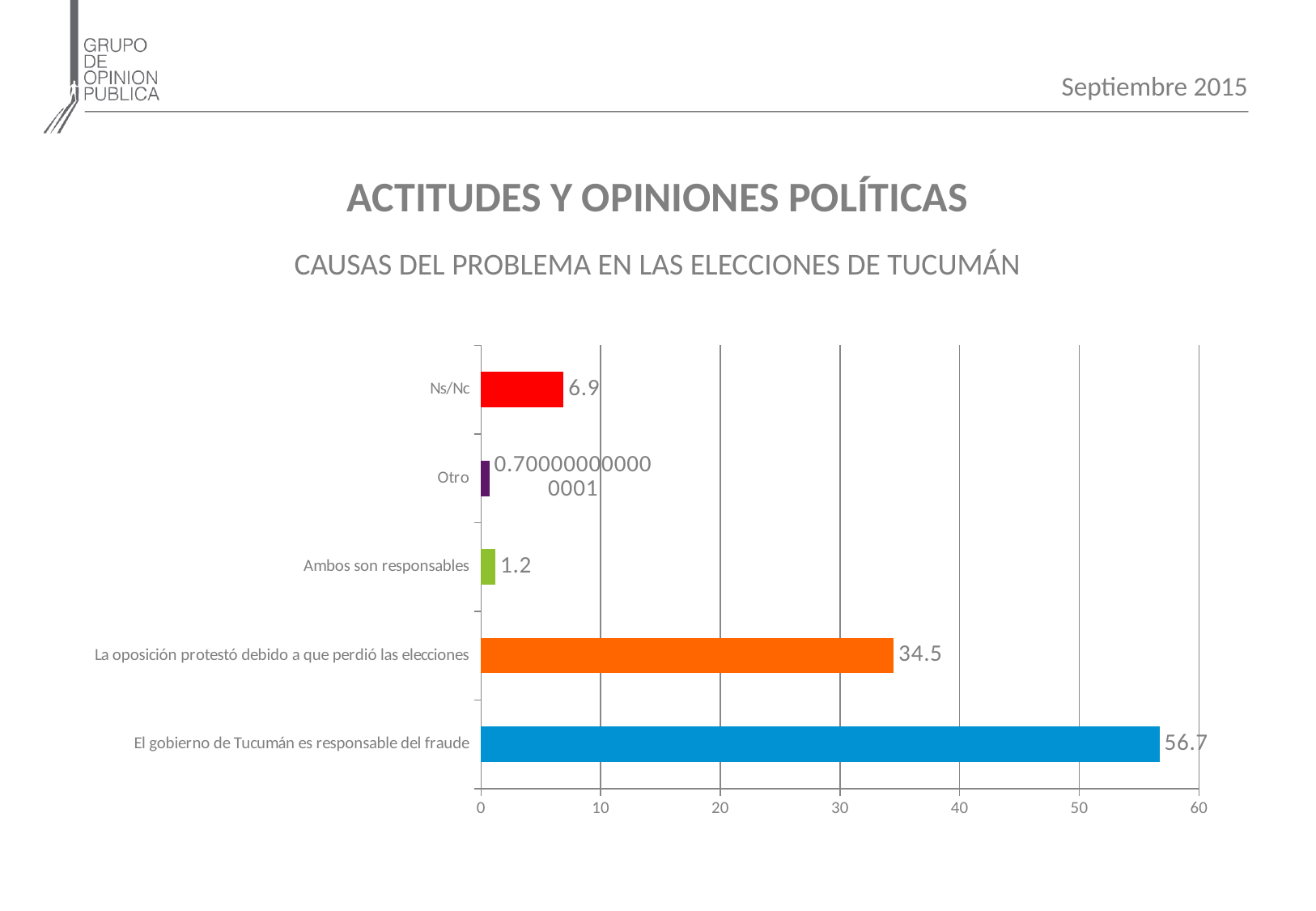
How many categories are shown in the chart? 5 Which category has the lowest value? Otro What is the value for "Ambos son responsables"? 1.2 What is the value for "Ns/Nc"? 6.9 Which is larger, the value for "Ns/Nc" or the value for "Ambos son responsables"? Ns/Nc What kind of chart is shown on the slide? Bar chart Which category has the highest value? El gobierno de Tucumán es responsable del fraude What is the difference between the values for "El gobierno de Tucumán es responsable del fraude" and "La oposición protestó debido a que perdió las elecciones"? 22.2 What is the subtitle of the chart on the slide? CAUSAS DEL PROBLEMA EN LAS ELECCIONES DE TUCUMÁN Is the value for "La oposición protestó debido a que perdió las elecciones" greater or less than 30? greater What is the value for "La oposición protestó debido a que perdió las elecciones"? 34.5 What is the value for "El gobierno de Tucumán es responsable del fraude"? 56.7